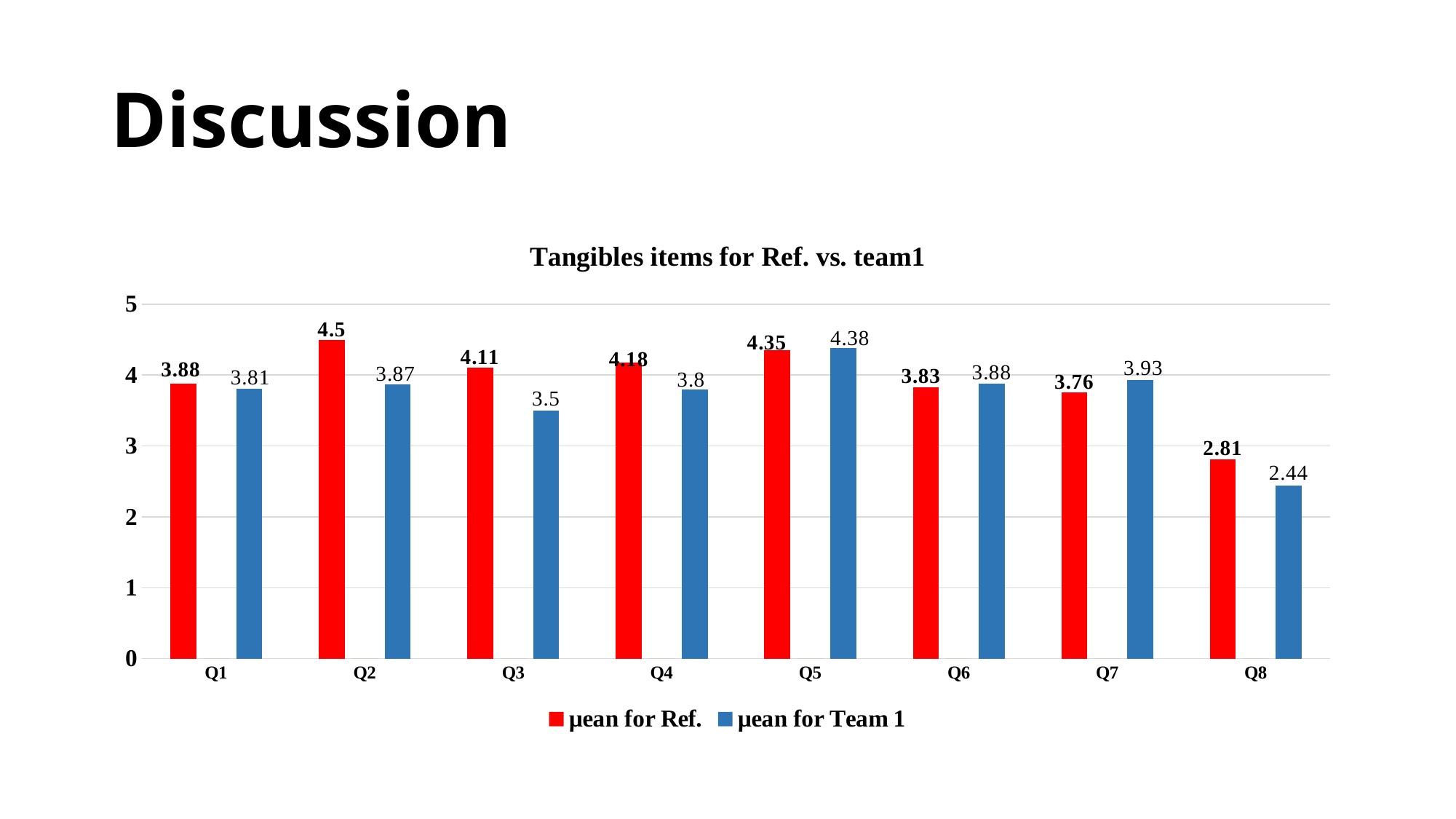
What kind of chart is shown on the slide? bar chart What is the title of the chart? Tangibles items for Ref. vs. team1 How many categories are shown on the x axis? 8 Which category has the highest value for μean for Ref.? Q2 What is the difference between μean for Ref. and μean for Team 1 for Q3? 0.61 Which is larger for Q7: μean for Ref. or μean for Team 1? μean for Team 1 How many series does the legend list? 2 What is the value of μean for Ref. for Q2? 4.5 Is the value of μean for Ref. for Q8 greater or less than 3? less What is the value of μean for Team 1 for Q8? 2.44 Which category has the lowest value for μean for Team 1? Q8 What is the value of μean for Team 1 for Q3? 3.5